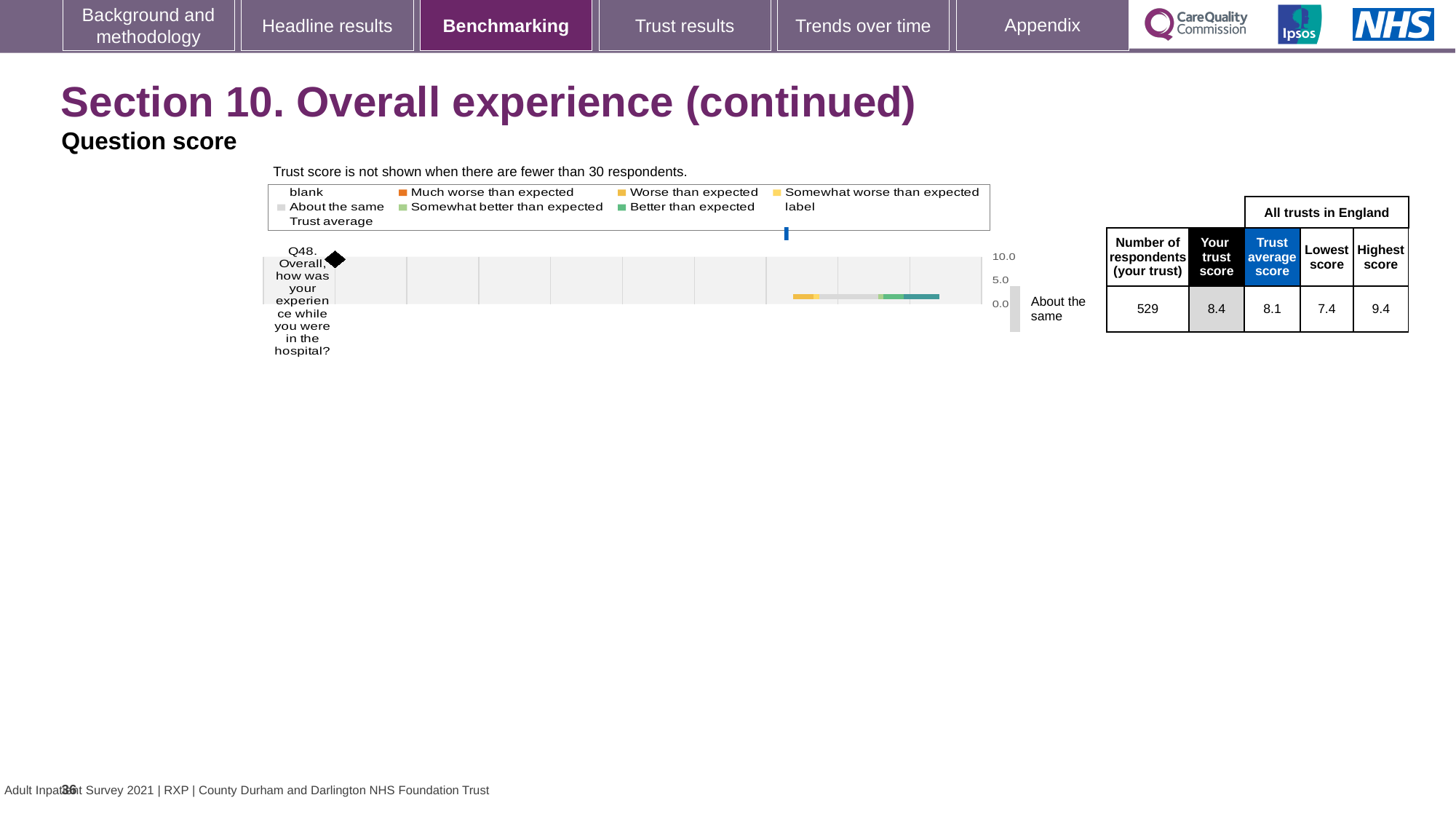
What is the trust score for Q48 shown in the table next to the chart? 8.4 Is the trust score for Q48 greater or less than 5.0 on the chart axis? greater What is the difference between the trust score and the trust average score for Q48? 0.3 How many respondents answered Q48 for this trust? 529 What is the difference between the highest score and the lowest score for Q48? 2.0 What is the lowest score among all trusts in England for Q48? 7.4 What benchmark category is the trust's Q48 score placed in? About the same What is the trust average score for Q48? 8.1 How many questions are plotted in the chart? 1 Which is larger for Q48, the trust score or the trust average score? trust score What kind of chart is used to show the Q48 question score? bar chart What is the highest score among all trusts in England for Q48? 9.4